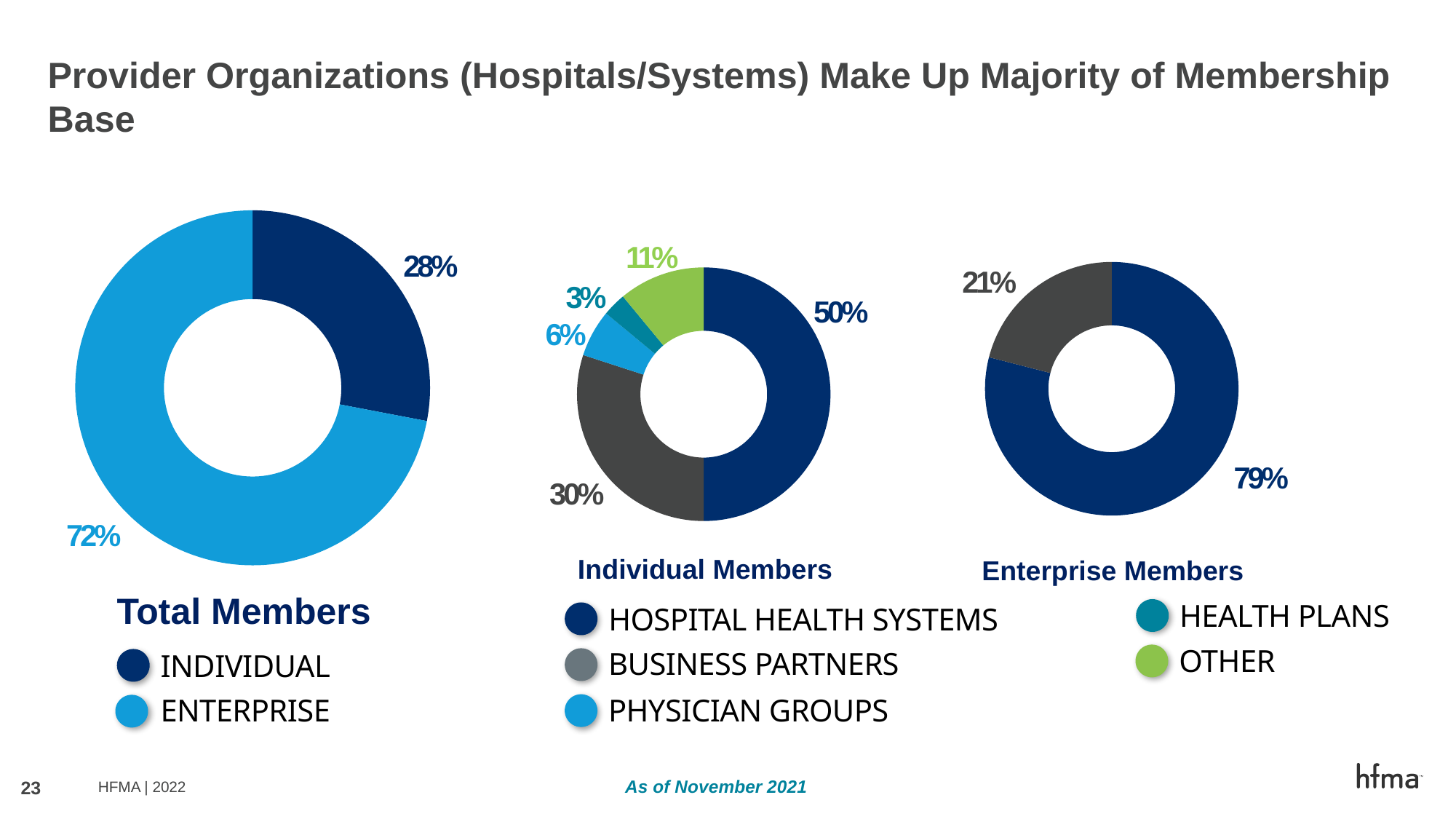
In the Individual Members chart, what percentage is Hospital Health Systems? 50% In the Individual Members chart, which category has the largest share? Hospital Health Systems In the Enterprise Members chart, what percentage is Business Partners? 21% In the Total Members chart, what share of members are Enterprise? 72% In the Individual Members chart, which category has the smallest share? Health Plans In the Individual Members chart, what percentage is Physician Groups? 6% In the Individual Members chart, what percentage is Health Plans? 3% In the Individual Members chart, what percentage is Business Partners? 30% How many slices does the Individual Members chart have? 5 In the Enterprise Members chart, what percentage is Hospital Health Systems? 79% In the Total Members chart, what share of members are Individual? 28% In the Individual Members chart, what is the difference between the Hospital Health Systems share and the Business Partners share? 20%